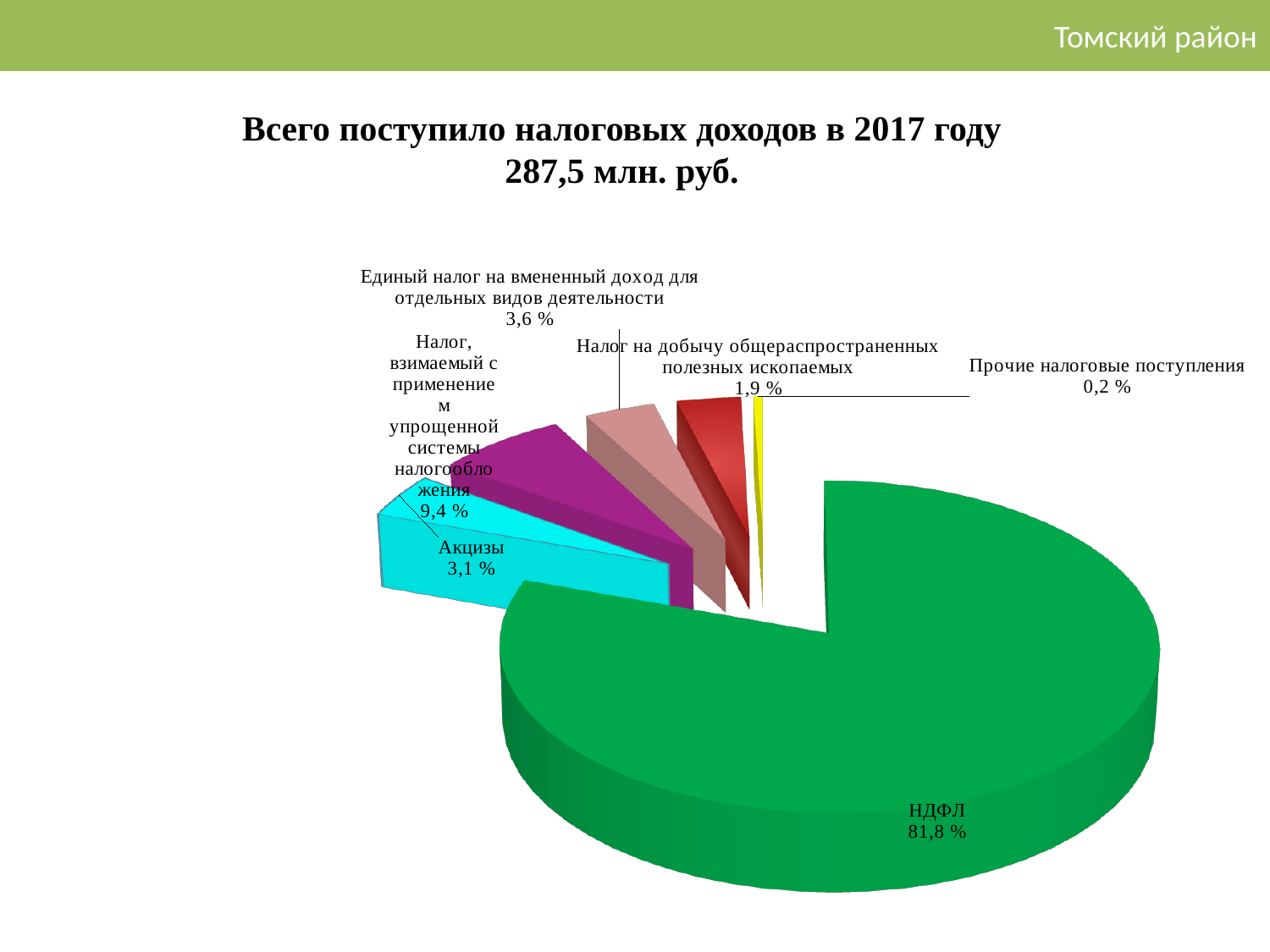
What share is shown for Акцизы? 3,1 % Which is larger: the share for Акцизы or the share for Единый налог на вмененный доход для отдельных видов деятельности? Единый налог на вмененный доход для отдельных видов деятельности What share of tax revenue does НДФЛ account for? 81,8 % What kind of chart is shown on the slide? Pie chart What share is shown for Прочие налоговые поступления? 0,2 % What share is shown for Налог, взимаемый с применением упрощенной системы налогообложения? 9,4 % What total amount of tax revenue for 2017 is stated in the chart title? 287,5 млн. руб. Which category has the largest share of the pie? НДФЛ What share is shown for Налог на добычу общераспространенных полезных ископаемых? 1,9 % Which category has the smallest share of the pie? Прочие налоговые поступления How many slices does the pie chart have? 6 What share is shown for Единый налог на вмененный доход для отдельных видов деятельности? 3,6 %